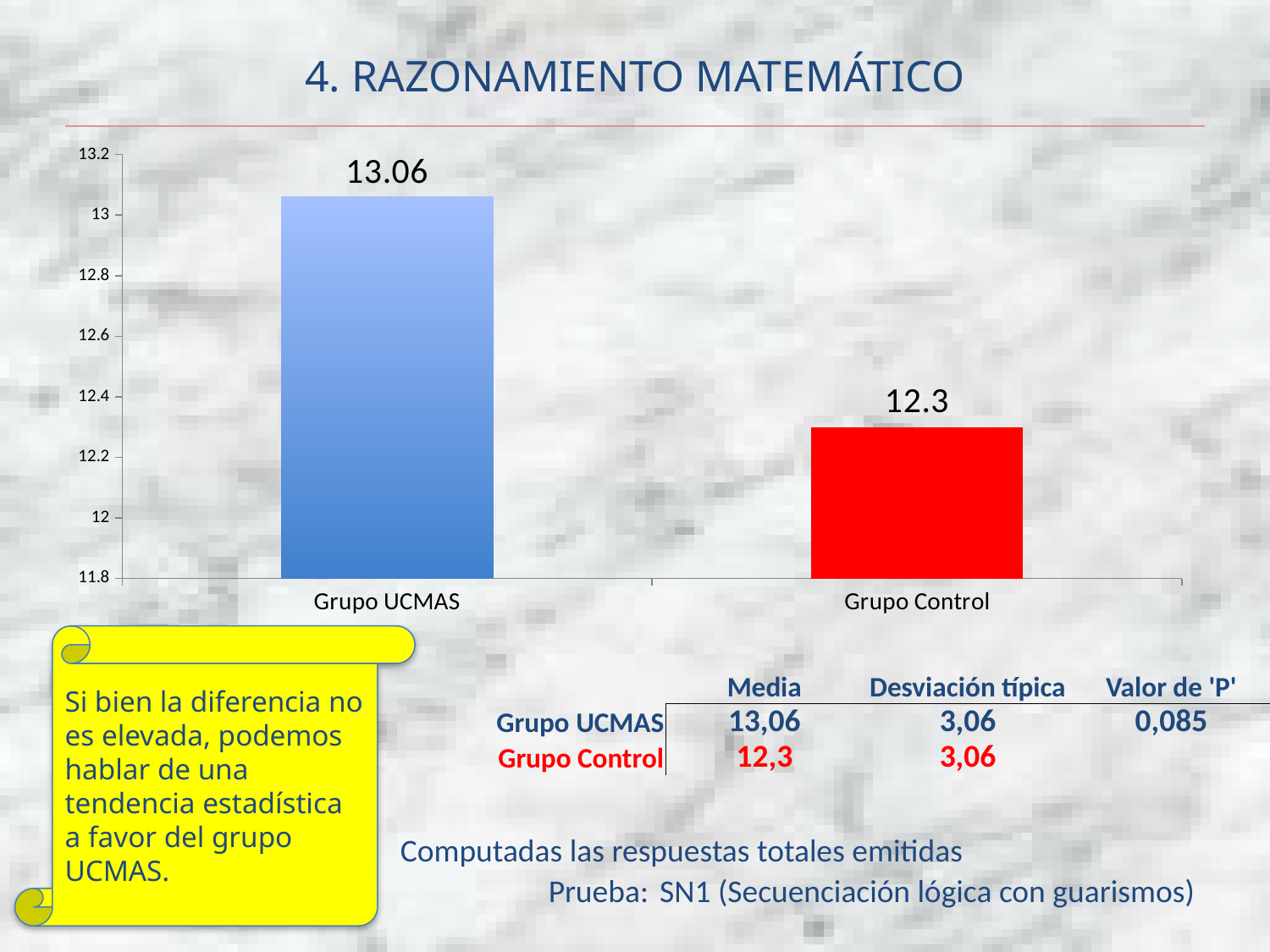
How many categories are shown in the chart? 2 What is the difference between the values for Grupo UCMAS and Grupo Control? 0.76 What is the value for Grupo Control? 12.3 Which group has the lowest value? Grupo Control Is the value for Grupo Control greater or less than 12.4? less What is the value for Grupo UCMAS? 13.06 What colour is the bar for Grupo Control? red Which group has the highest value? Grupo UCMAS Which is larger, the value for Grupo UCMAS or the value for Grupo Control? Grupo UCMAS Is the value for Grupo UCMAS greater or less than 13? greater What kind of chart is shown on the slide? bar chart What is the lowest value shown on the vertical axis? 11.8